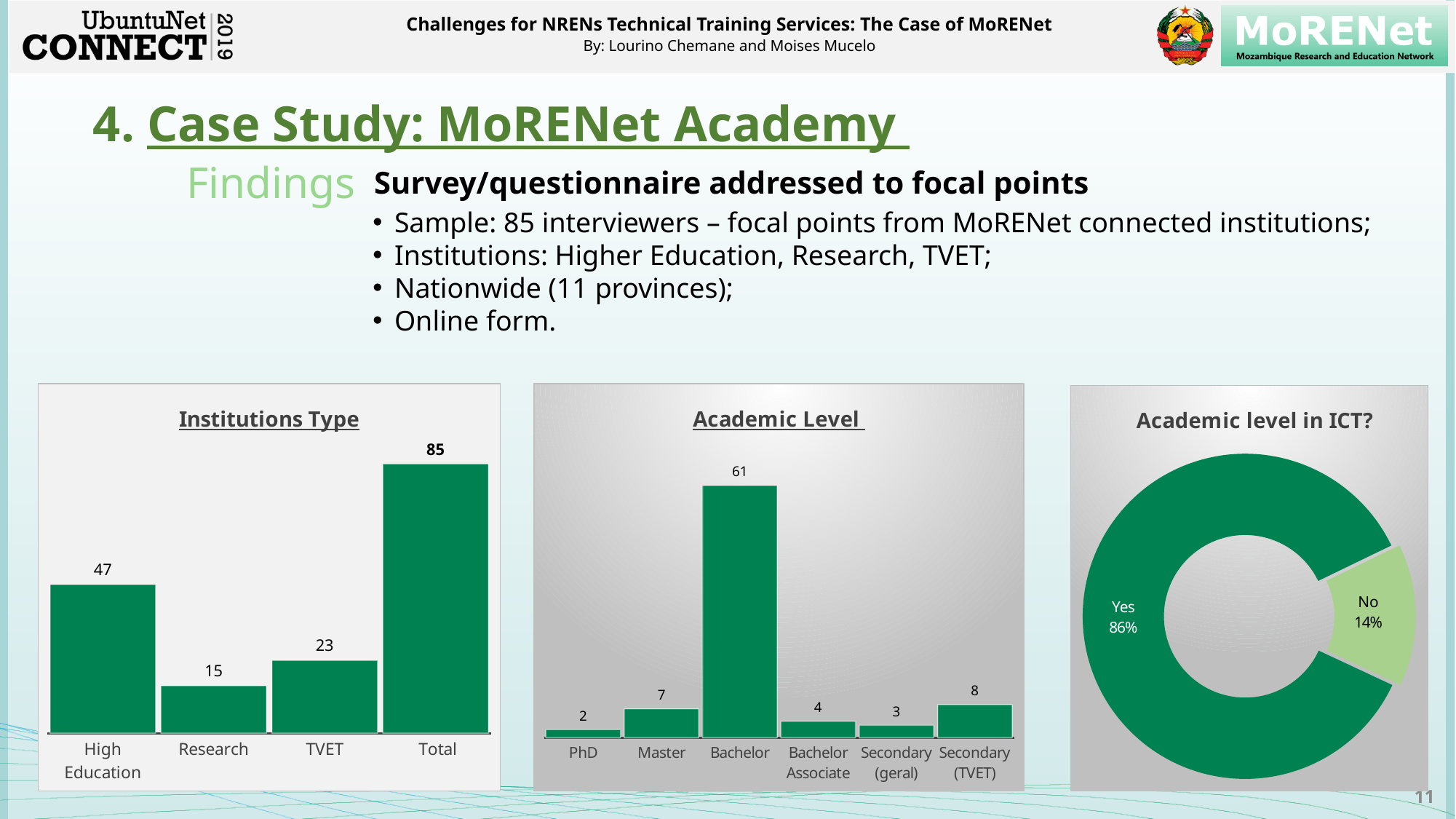
What kind of chart is the 'Academic level in ICT?' chart? Doughnut (pie) chart In the 'Academic Level' chart, how many categories are shown on the x axis? 6 In the 'Academic Level' chart, which is larger, the value for Master or the value for Bachelor Associate? Master In the 'Institutions Type' chart, what is the value for Research? 15 In the 'Institutions Type' chart, which category has the lowest value? Research In the 'Institutions Type' chart, what is the difference between the High Education and TVET values? 24 In the 'Academic Level' chart, which category has the lowest value? PhD In the 'Academic Level' chart, what is the value for Secondary (TVET)? 8 In the 'Institutions Type' chart, what is the value for High Education? 47 In the 'Academic level in ICT?' chart, what share of the pie is 'No'? 14% What kind of chart is the 'Institutions Type' chart? Bar chart In the 'Academic Level' chart, what is the value for Bachelor? 61